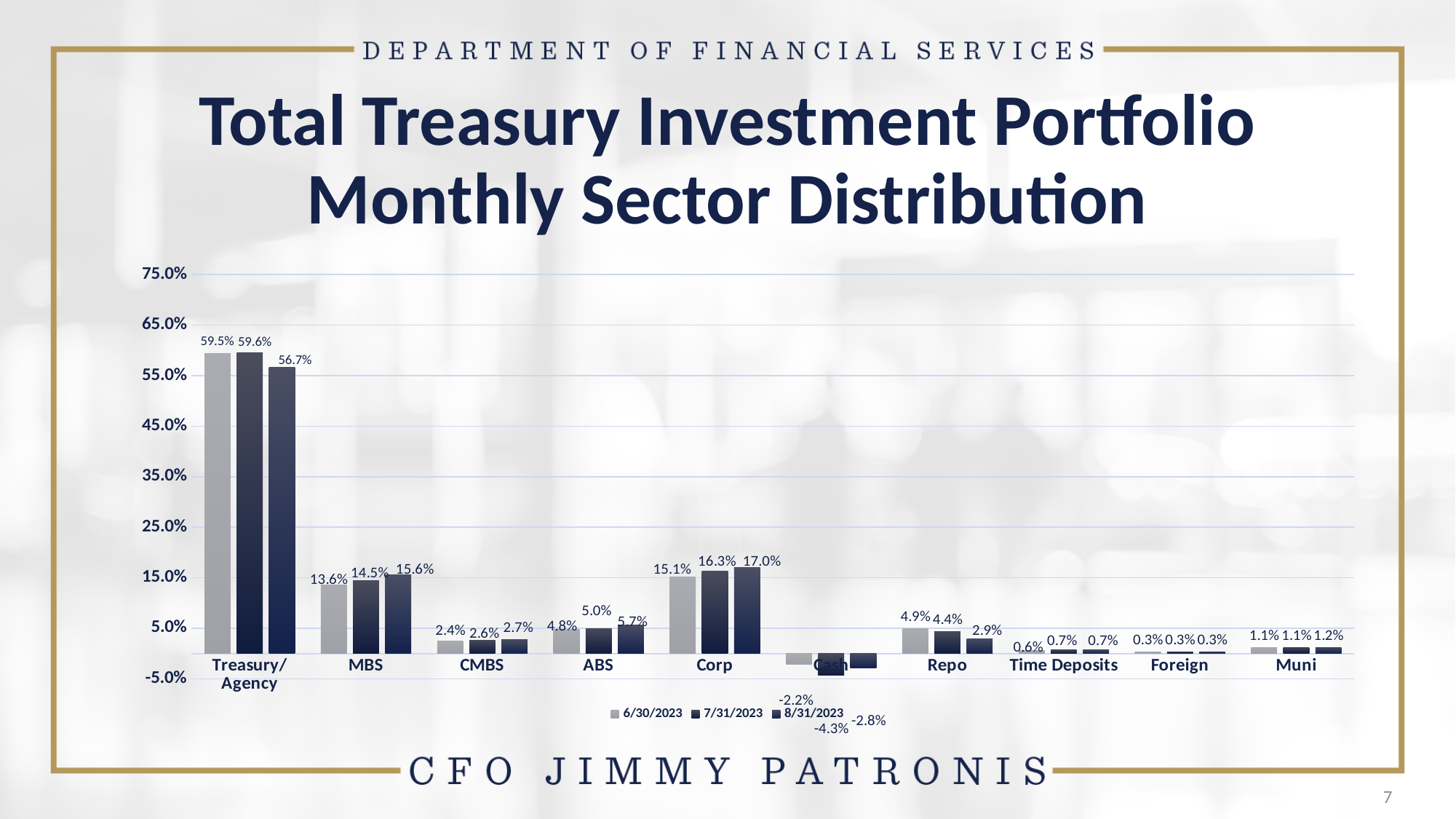
Which sector has the highest value for 6/30/2023? Treasury/Agency What is the value for Cash for 7/31/2023? -4.3% What is the value for ABS for 8/31/2023? 5.7% What is the value for Treasury/Agency for 8/31/2023? 56.7% What is the difference between the MBS values for 8/31/2023 and 6/30/2023? 2.0% How many series does the legend list? 3 Which sector has the lowest value for 8/31/2023? Cash What kind of chart is shown on the slide? Bar chart Which is larger for Repo: the 6/30/2023 value or the 8/31/2023 value? 6/30/2023 What is the value for Corp for 7/31/2023? 16.3% How many sector categories are shown on the x axis? 10 Do the Corp values rise or fall from 6/30/2023 to 8/31/2023? Rise